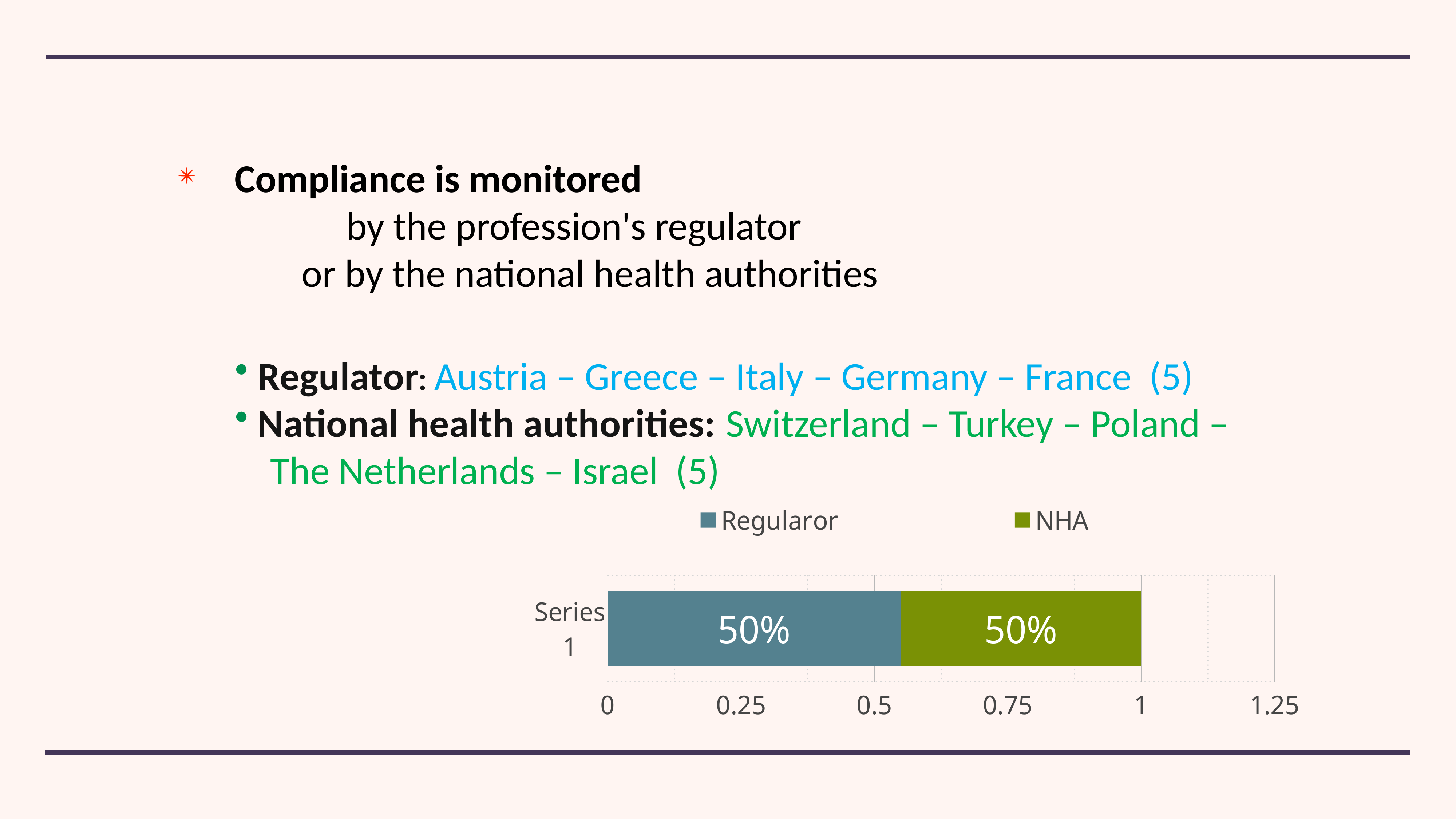
What value is shown for the NHA series in the bar chart? 50% What kind of chart is shown on the slide? Stacked bar chart What value is shown for the Regularor series in the bar chart? 50% How many series does the legend of the chart list? 2 Which legend entry is shown in green in the chart? NHA What is the total of the two labelled segments in the stacked bar? 100% What is the name of the single category shown on the chart's vertical axis? Series 1 How many categories are plotted on the chart's vertical axis? 1 What is the highest tick value shown on the chart's horizontal axis? 1.25